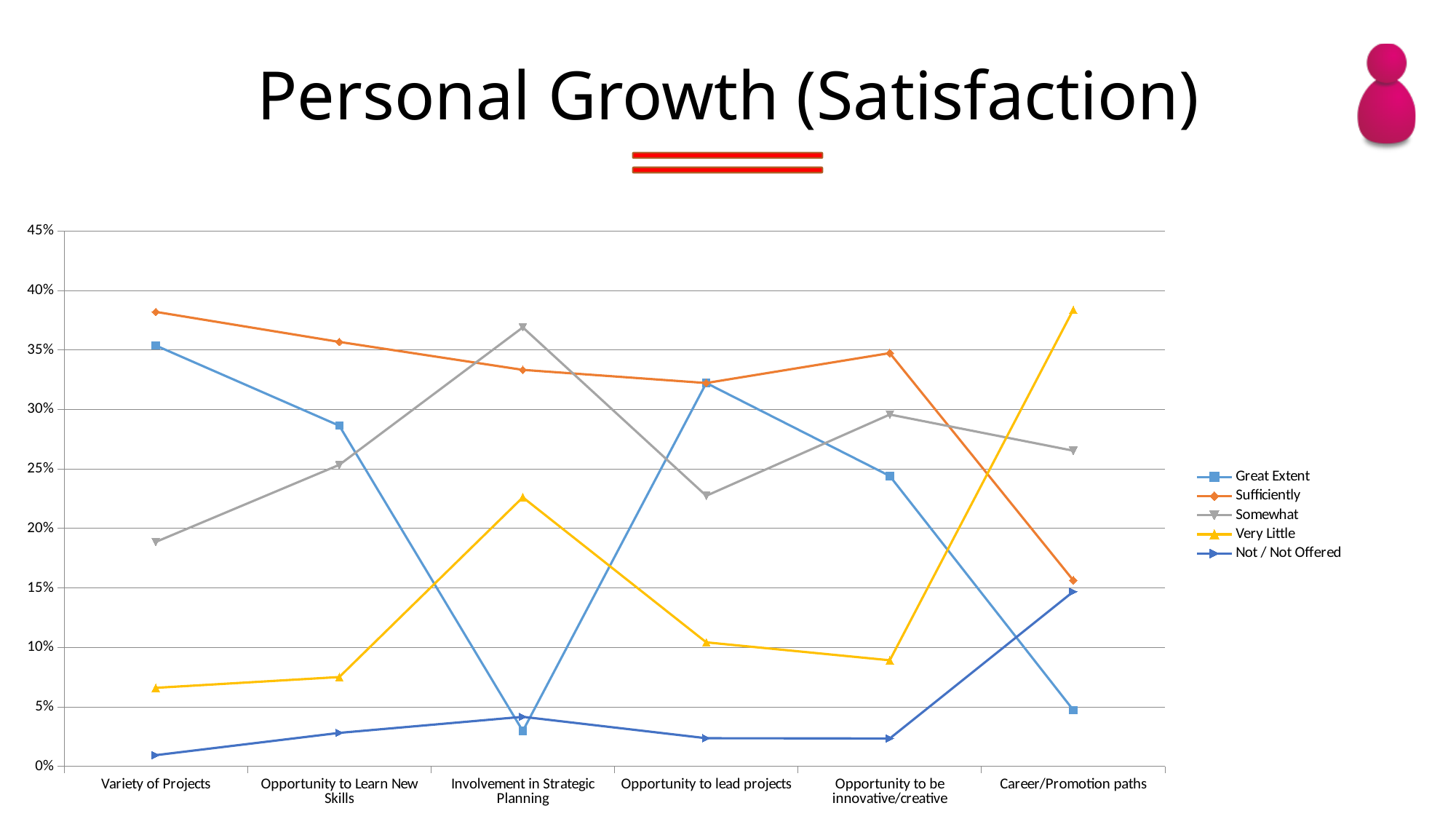
How many series does the legend list? 5 Is the Somewhat value for Variety of Projects greater or less than 20%? less What colour is the Very Little line in the legend? yellow What kind of chart is shown on the slide? line chart Is the Very Little value for Career/Promotion paths greater or less than 35%? greater Which series has the highest value for Variety of Projects? Sufficiently For which category does the Somewhat series reach its highest value? Involvement in Strategic Planning Which series has the lowest value for Career/Promotion paths? Great Extent Does the Not / Not Offered line rise or fall from Opportunity to be innovative/creative to Career/Promotion paths? rises How many categories are shown on the x axis? 6 For Involvement in Strategic Planning, which is larger: Somewhat or Sufficiently? Somewhat Is the Great Extent value for Involvement in Strategic Planning greater or less than 5%? less